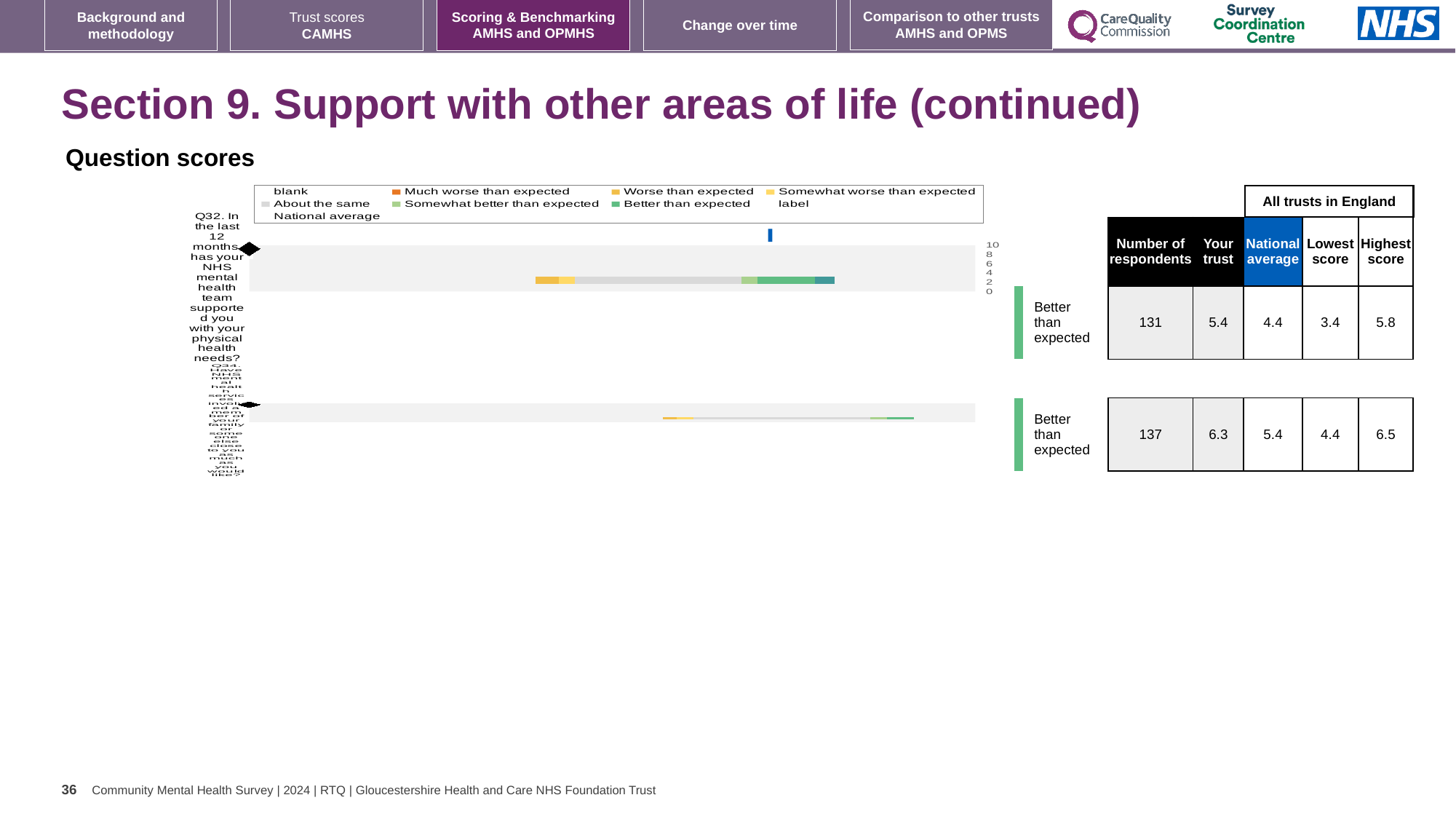
How many respondents answered Q34? 137 What is the difference between the 'Your trust' score and the national average for Q32? 1.0 How many questions (categories) are plotted in the question scores chart? 2 What is the difference between the highest and lowest trust scores for Q34? 2.1 What is the 'Your trust' score for Q32 (support with physical health needs)? 5.4 What is the national average score for Q34 (involving family or someone close)? 5.4 What is the highest value shown on the chart's numeric axis? 10 What type of chart is used to show the question scores on this slide? bar chart What is the highest score across all trusts in England for Q34? 6.5 Which question has the higher 'Your trust' score, Q32 or Q34? Q34 What is the lowest score across all trusts in England for Q32? 3.4